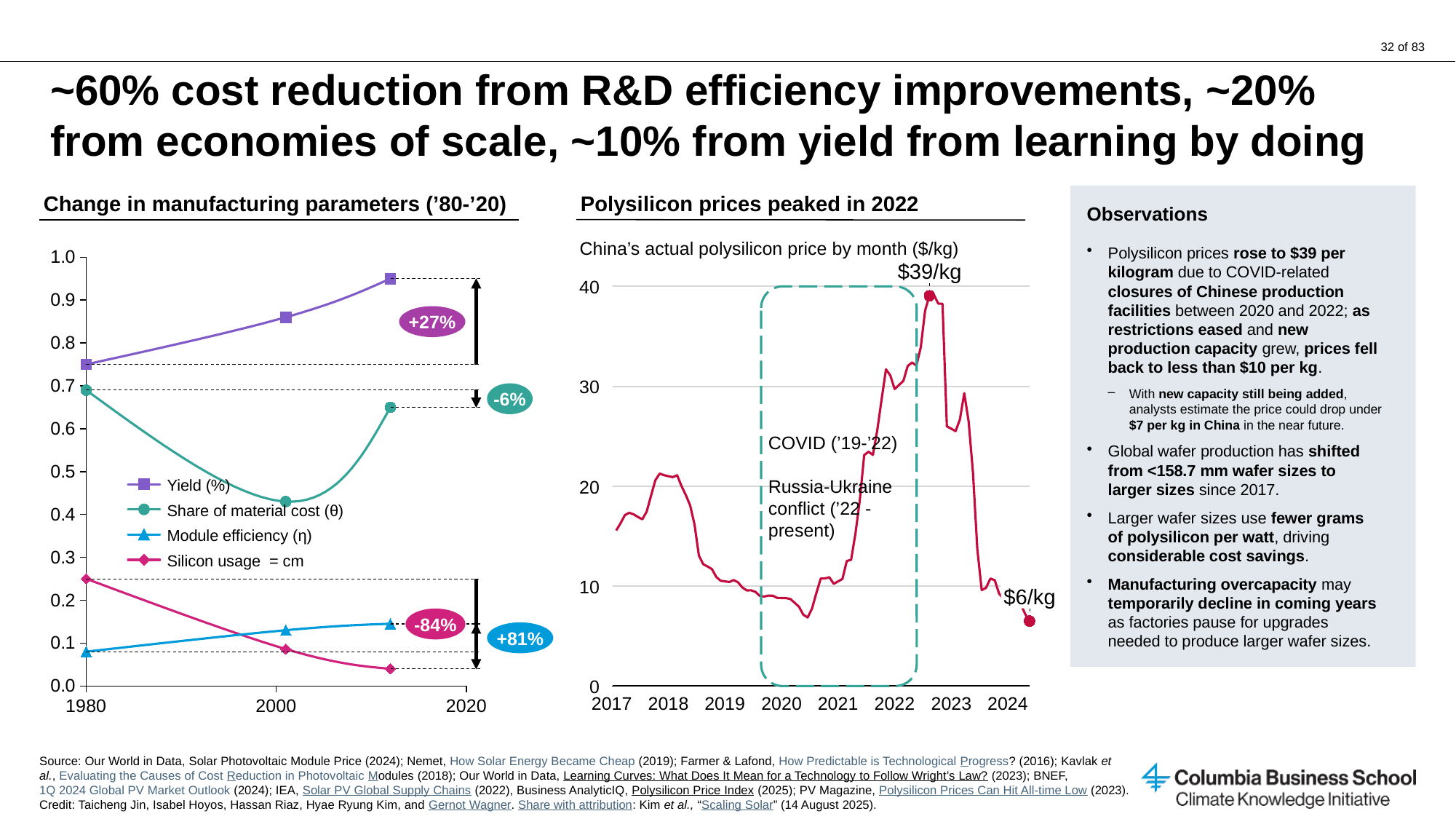
How many series does the legend of 'Change in manufacturing parameters ('80-'20)' list? 4 In 'Polysilicon prices peaked in 2022', what peak price is labelled on the chart? $39/kg In 'Change in manufacturing parameters ('80-'20)', is the value for Silicon usage in 1980 greater or less than 0.2? greater In 'Change in manufacturing parameters ('80-'20)', is the value for Yield (%) in 2020 greater or less than 0.9? greater What kind of chart is 'Change in manufacturing parameters ('80-'20)'? line chart In 'Change in manufacturing parameters ('80-'20)', what percentage change is annotated for Silicon usage? -84% In 'Polysilicon prices peaked in 2022', does the price rise or fall from its 2022 peak to 2024? fall In 'Change in manufacturing parameters ('80-'20)', which is higher in 2020: Yield (%) or Share of material cost (θ)? Yield (%) In 'Change in manufacturing parameters ('80-'20)', what percentage change is annotated for Yield (%)? +27% In 'Polysilicon prices peaked in 2022', what price is labelled at the end of the line in 2024? $6/kg In 'Change in manufacturing parameters ('80-'20)', what percentage change is annotated for Share of material cost (θ)? -6% In 'Change in manufacturing parameters ('80-'20)', what percentage change is annotated for Module efficiency (η)? +81%